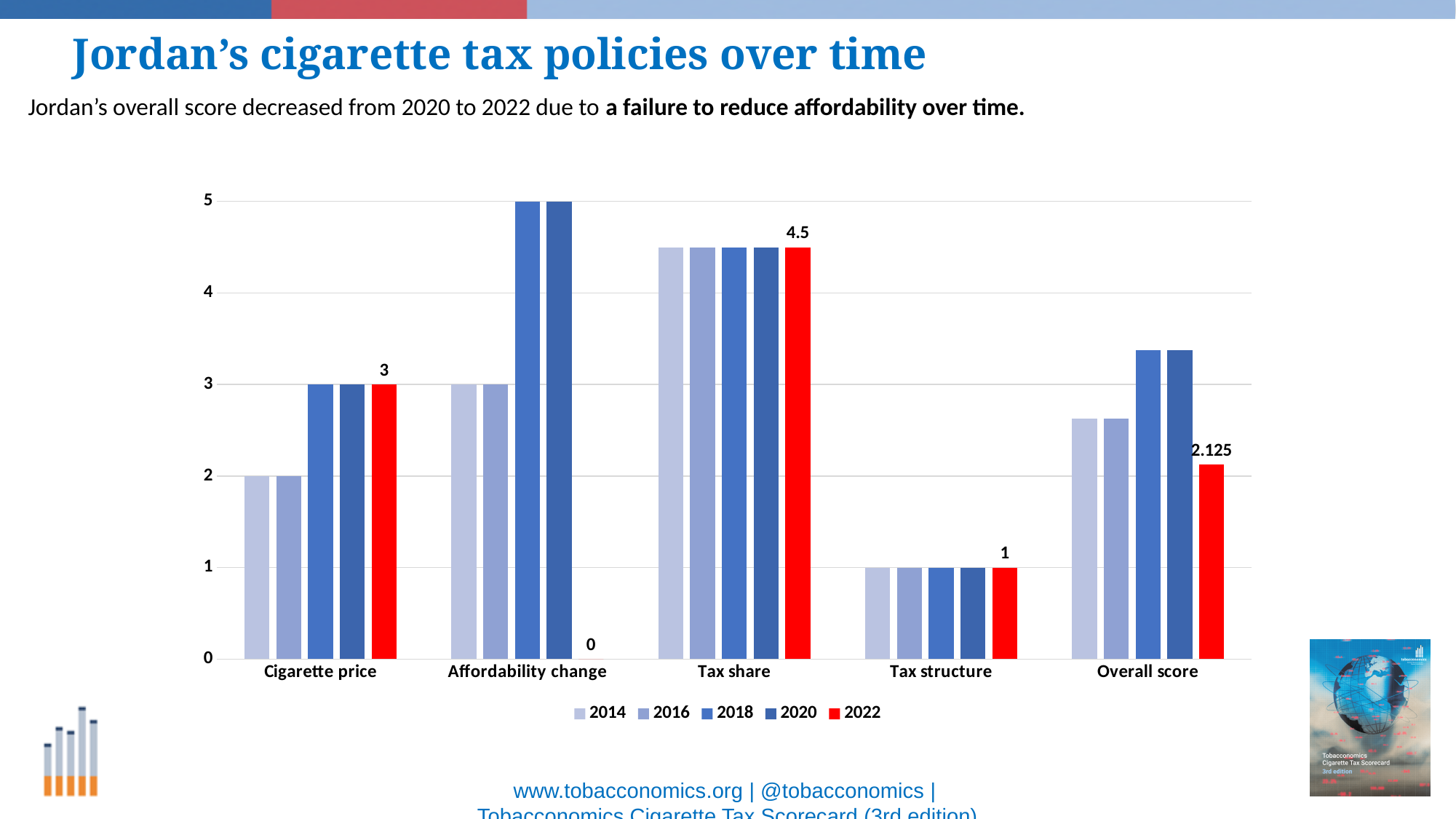
What is the value for Affordability change in 2020? 5 How many series does the legend list? 5 What is the value for Cigarette price in 2022? 3 Is the Overall score for 2020 greater or less than 3? greater What is the value for Affordability change in 2022? 0 Among the 2022 bars, which category has the lowest value? Affordability change What is the difference between the 2022 values for Tax share and Cigarette price? 1.5 What is the Overall score for 2022? 2.125 How many categories are shown on the x axis? 5 What kind of chart is shown on the slide? bar chart What is the value for Tax share in 2022? 4.5 Among the 2022 bars, which category has the highest value? Tax share